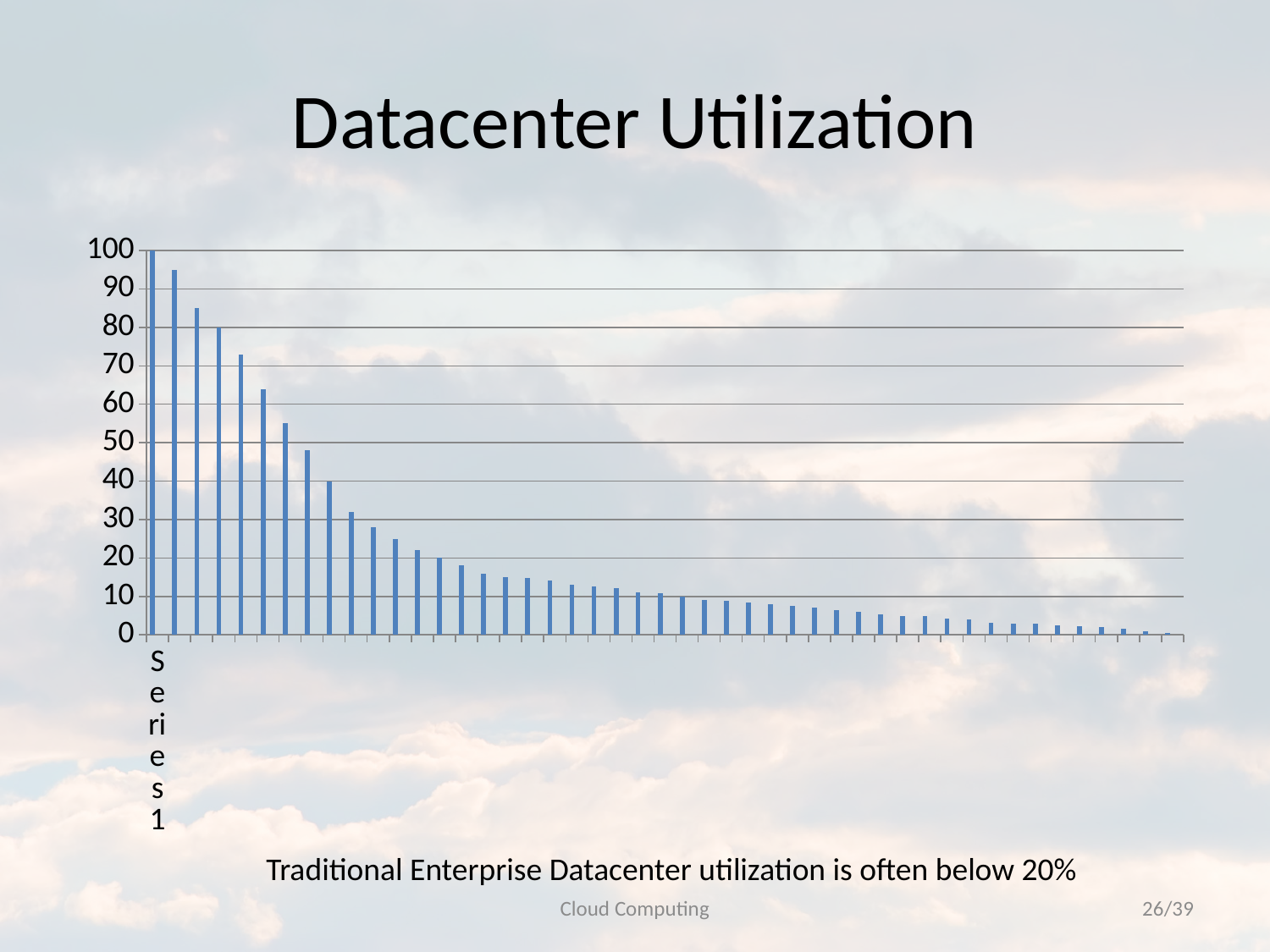
Do the bar values rise or fall from left to right along the x axis? fall Is the value of the rightmost bar greater or less than 10? less Which bar is the lowest in the chart, the leftmost or the rightmost? the rightmost Is the value of the third bar from the left greater or less than 80? greater Which bar is the highest in the chart, the leftmost or the rightmost? the leftmost Is the value of the fifth bar from the left greater or less than 70? greater What kind of chart is shown on the slide? bar chart What is the title of the chart on the slide? Datacenter Utilization What colour are the bars in the chart? blue Is the leftmost bar larger or smaller than the second bar from the left? larger